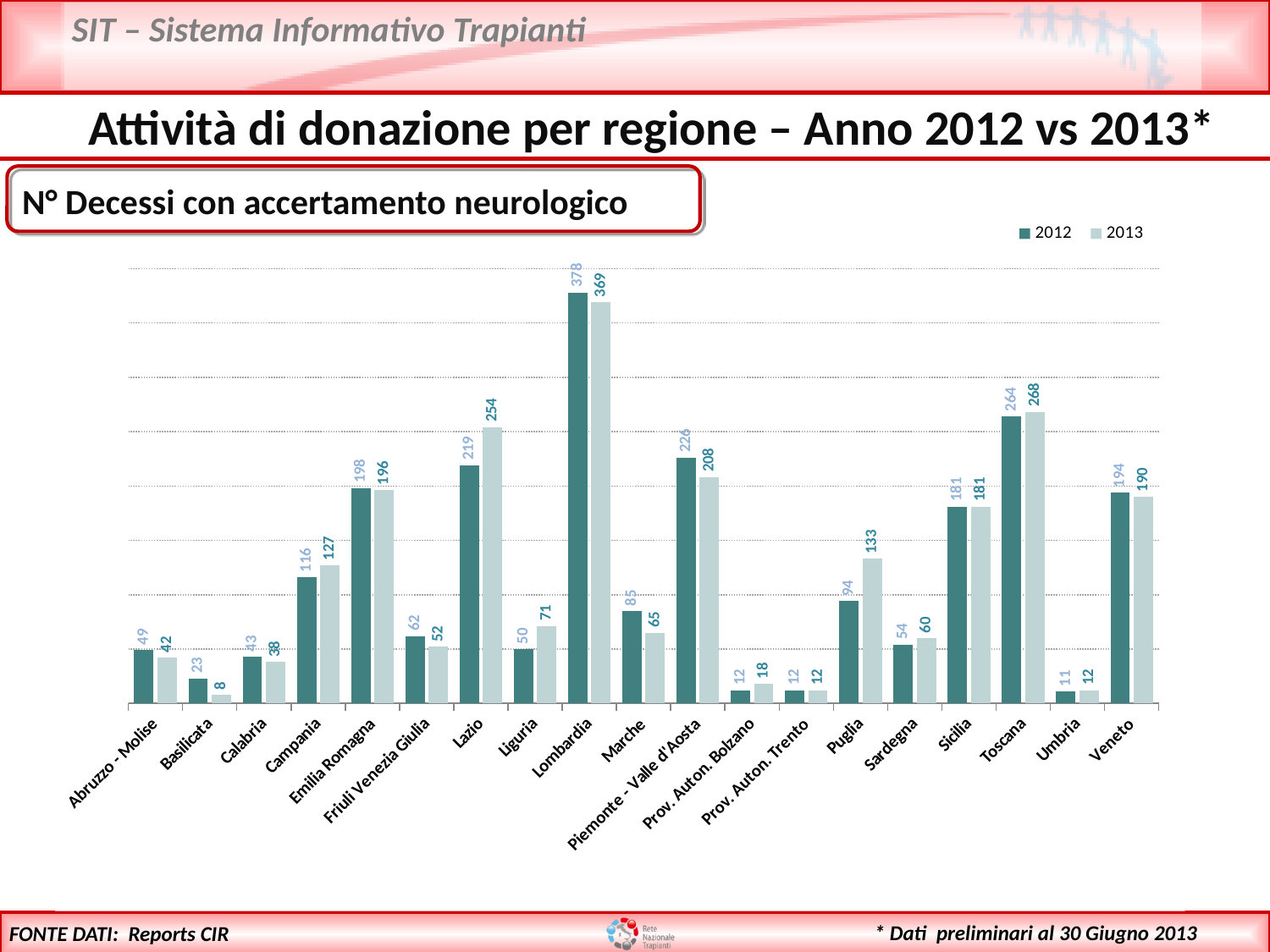
What kind of chart is shown on the slide? Bar chart What is the difference between the 2012 and 2013 values for Basilicata? 15 Which is larger for Campania, the 2012 value or the 2013 value? 2013 What is the 2012 value for Lombardia? 378 How many series does the legend list? 2 What is the 2013 value for Lazio? 254 Which is larger, the 2012 value for Toscana or the 2012 value for Piemonte - Valle d'Aosta? Toscana Which region has the lowest 2013 value? Basilicata What is the 2013 value for Puglia? 133 Which region has the highest 2013 value? Lombardia What is the difference between the 2012 and 2013 values for Lazio? 35 How many regions are shown on the x axis? 19